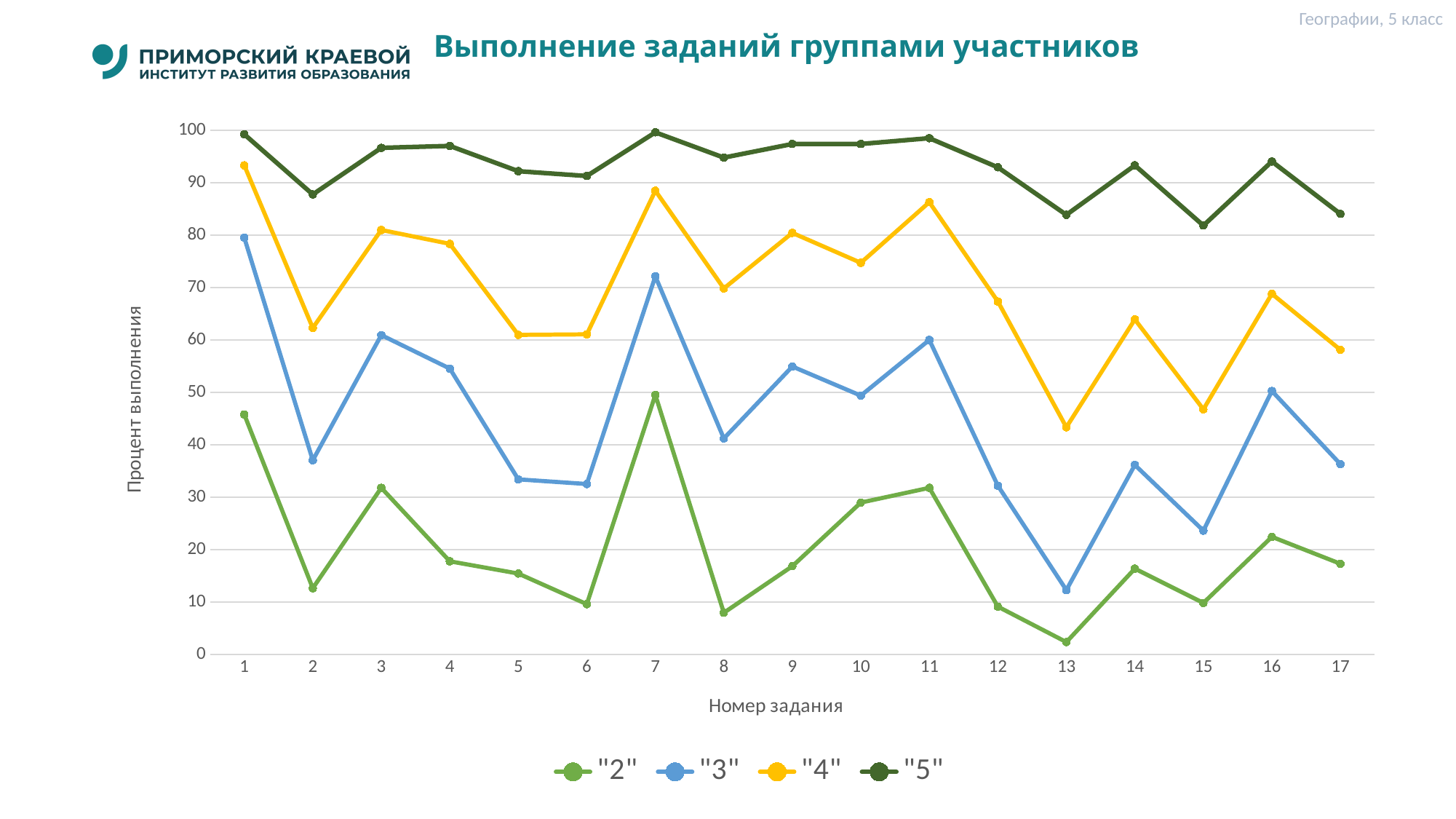
Is the value for series "2" at task 13 greater or less than 10? less Is the value for series "3" at task 1 greater or less than 70? greater Is the value for series "4" at task 13 greater or less than 50? less For series "2", at which task number is the value lowest? 13 For series "5", do the values rise or fall from task 11 to task 13? Fall How many series does the legend list? 4 For series "2", which is larger: the value at task 7 or the value at task 11? Task 7 For series "3", at which task number is the value highest? 1 What kind of chart is shown on the slide? Line chart What is the title of the vertical axis? Процент выполнения How many tasks (points on the x axis) are plotted? 17